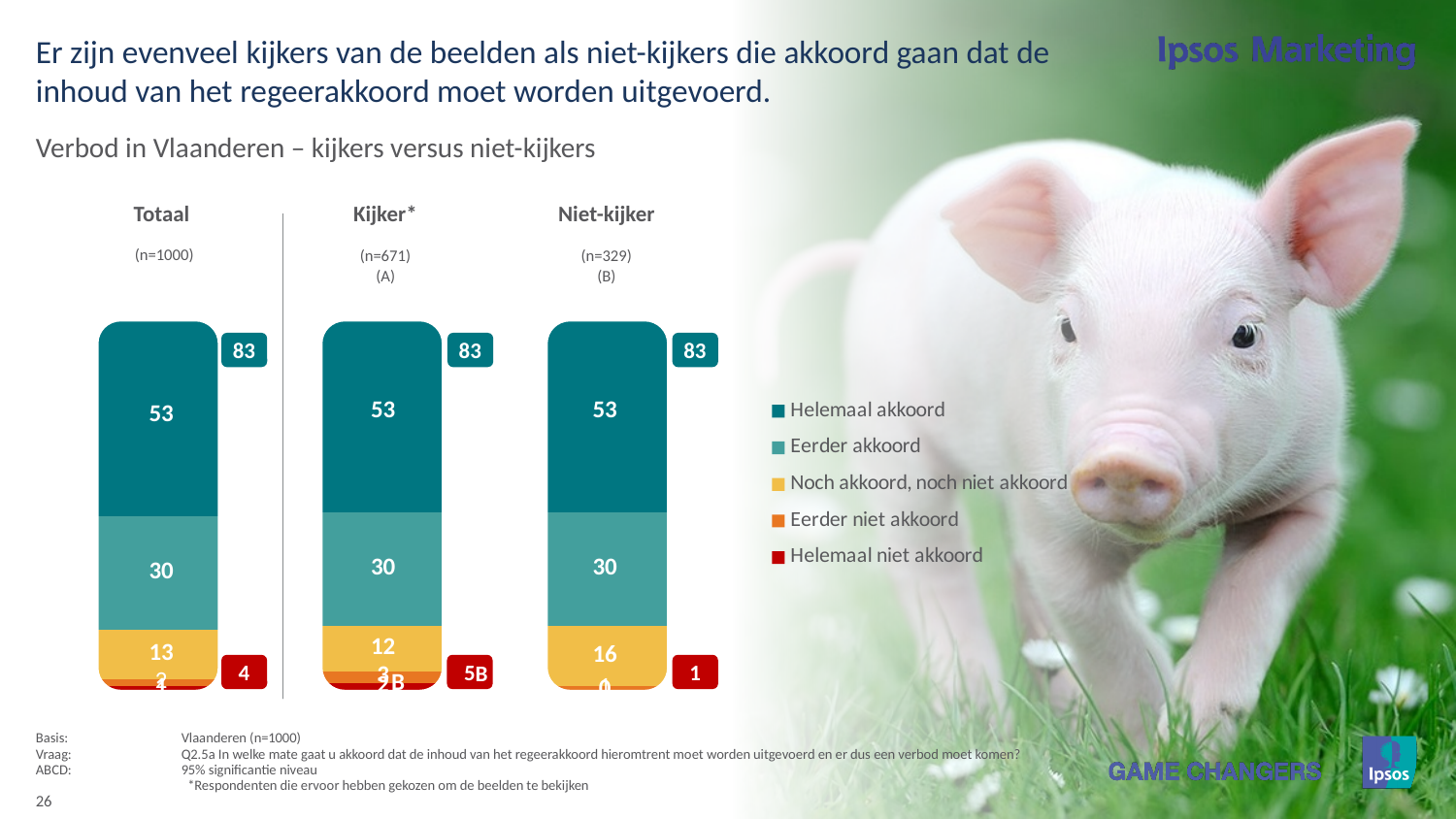
What kind of chart is shown on the slide? Stacked bar chart Which is larger for Noch akkoord, noch niet akkoord: Totaal or Kijker? Totaal What is the value for Eerder akkoord in the Kijker bar? 30 What is the difference between the Noch akkoord, noch niet akkoord values for Niet-kijker and Kijker? 4 Which group has the highest value for Noch akkoord, noch niet akkoord? Niet-kijker What is the value for Noch akkoord, noch niet akkoord in the Kijker bar? 12 What is the value for Noch akkoord, noch niet akkoord in the Totaal bar? 13 How many series does the legend list? 5 How many groups (bars) are shown in the chart? 3 What is the sample size shown for the Kijker group? n=671 What is the value for Helemaal akkoord in the Totaal bar? 53 What is the value for Noch akkoord, noch niet akkoord in the Niet-kijker bar? 16